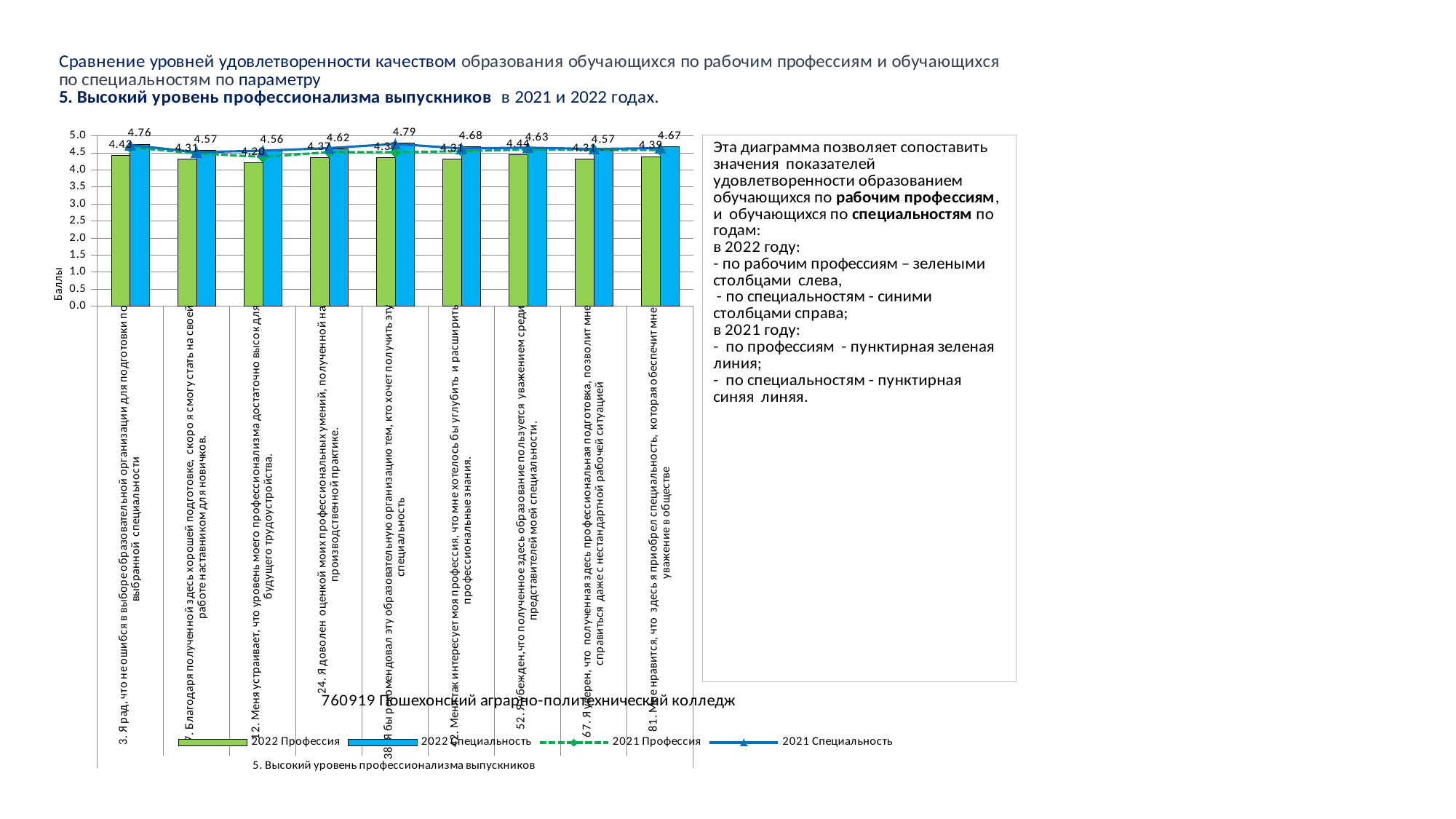
What is the label of the vertical axis of the chart? Баллы What is the value of the 2022 Профессия bar for the category "3. Я рад, что не ошибся в выборе образовательной организации для подготовки по выбранной специальности"? 4.43 How many categories are shown on the x axis of the chart? 9 What is the value of the 2022 Специальность bar for the category "24. Я доволен оценкой моих профессиональных умений, полученной на производственной практике"? 4.62 Is the 2022 Профессия value for the category "81. Мне нравится, что здесь я приобрел специальность, которая обеспечит мне уважение в обществе" greater or less than 4.0? greater What is the value of the 2022 Профессия bar for the category "81. Мне нравится, что здесь я приобрел специальность, которая обеспечит мне уважение в обществе"? 4.39 For the category "24. Я доволен оценкой моих профессиональных умений, полученной на производственной практике", which is larger: the 2022 Профессия bar or the 2022 Специальность bar? 2022 Специальность What is the lowest value among the 2022 Профессия bars? 4.20 What is the value of the 2022 Специальность bar for the category "3. Я рад, что не ошибся в выборе образовательной организации для подготовки по выбранной специальности"? 4.76 How many series does the chart legend list? 4 What is the difference between the 2022 Специальность and 2022 Профессия values for the category "3. Я рад, что не ошибся в выборе образовательной организации для подготовки по выбранной специальности"? 0.33 What is the highest value among the 2022 Специальность bars? 4.79